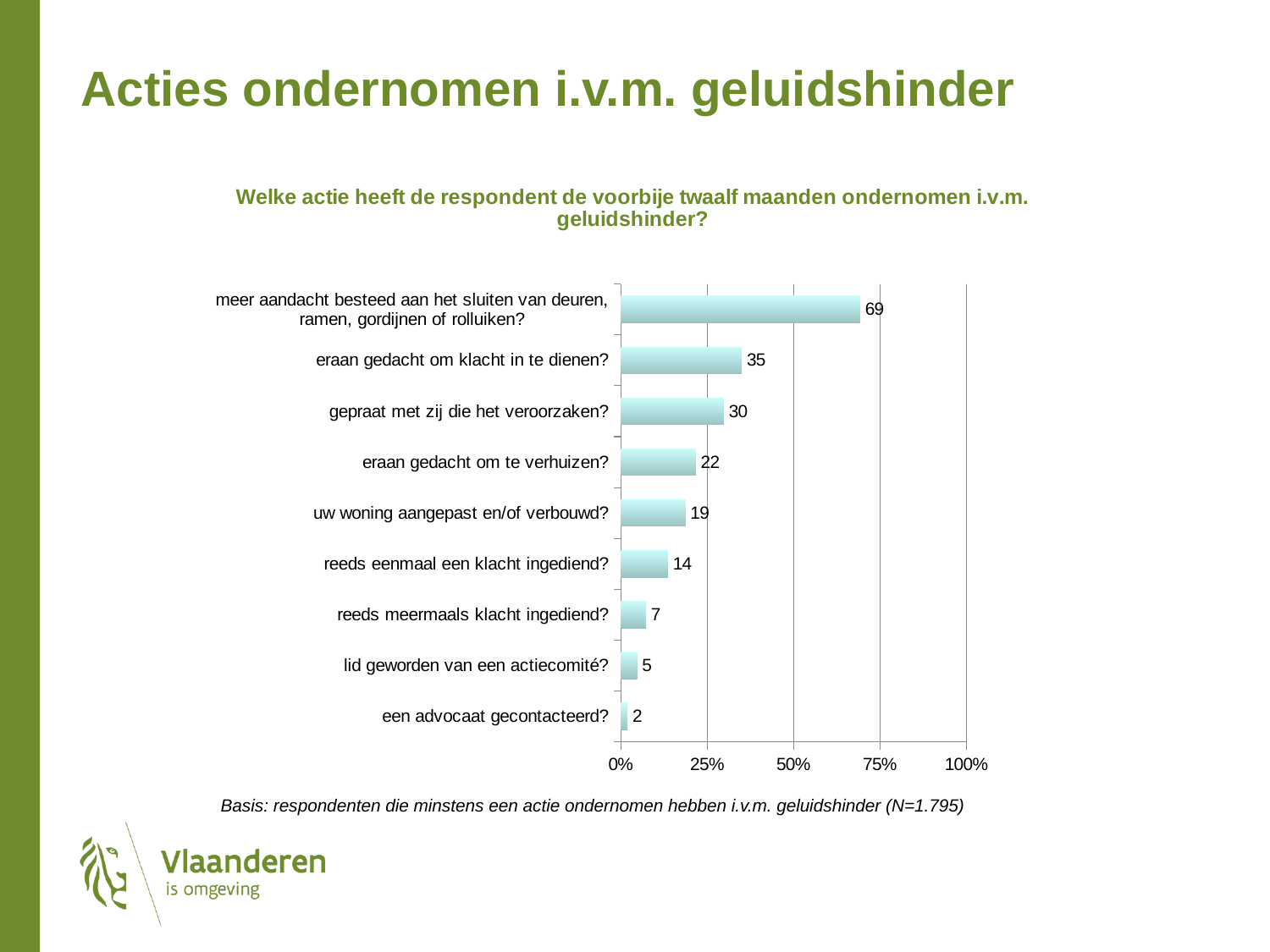
Is the value for "meer aandacht besteed aan het sluiten van deuren, ramen, gordijnen of rolluiken?" greater or less than 50%? greater Which category has the lowest value? een advocaat gecontacteerd? How many categories are shown in the chart? 9 What is the sample size (N) stated in the note below the chart? N=1.795 What is the value for "uw woning aangepast en/of verbouwd?"? 19 Which category has the highest value? meer aandacht besteed aan het sluiten van deuren, ramen, gordijnen of rolluiken? What is the difference between the values for "gepraat met zij die het veroorzaken?" and "eraan gedacht om te verhuizen?"? 8 What is the value for "lid geworden van een actiecomité?"? 5 What kind of chart is shown on the slide? bar chart What is the value for "eraan gedacht om klacht in te dienen?"? 35 What is the highest tick label on the horizontal axis? 100% Which is larger: the value for "reeds eenmaal een klacht ingediend?" or "reeds meermaals klacht ingediend?"? reeds eenmaal een klacht ingediend?